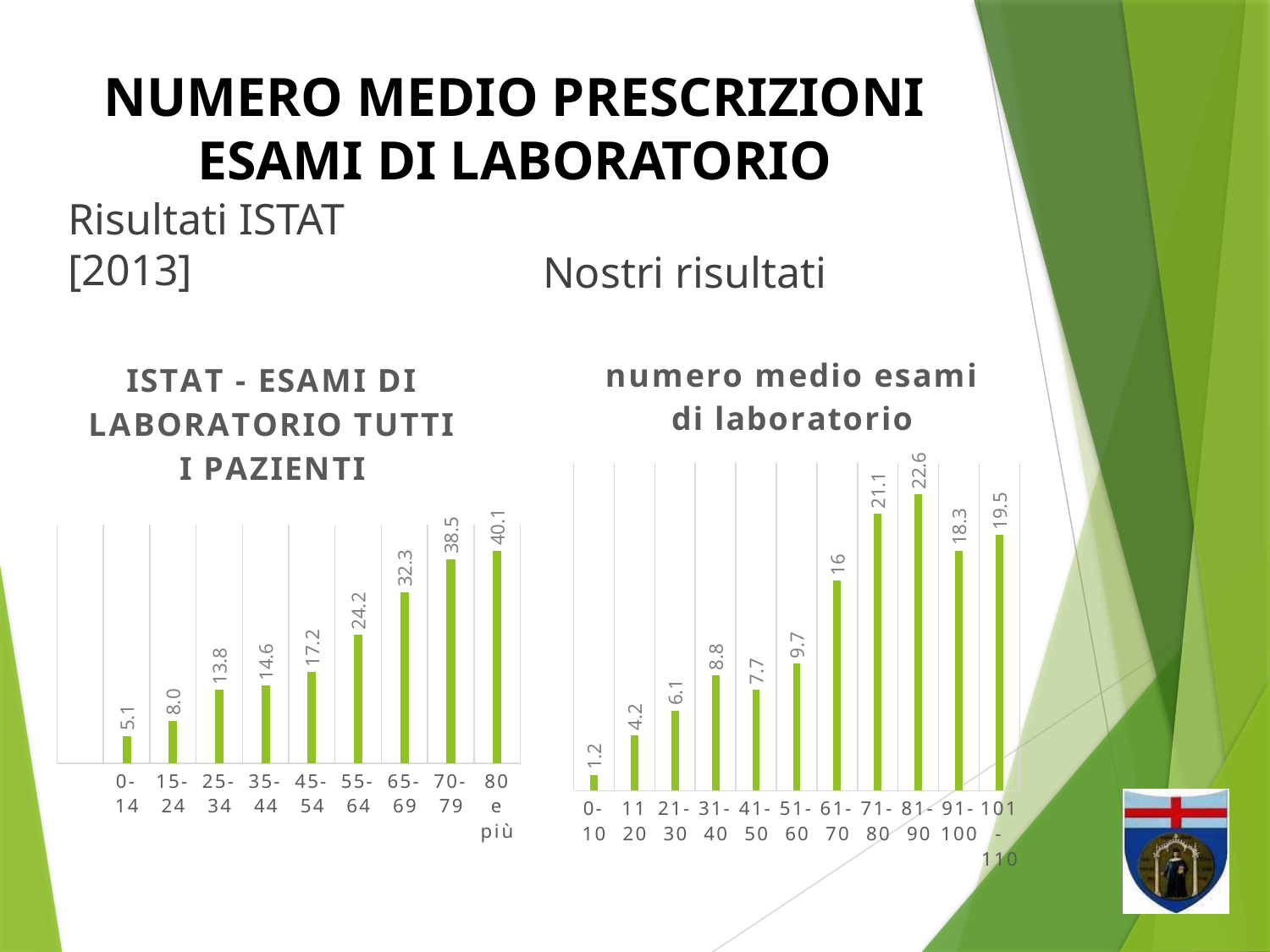
In the chart titled 'ISTAT - ESAMI DI LABORATORIO TUTTI I PAZIENTI', what is the difference between the values for 70-79 and 65-69? 6.2 In the chart titled 'ISTAT - ESAMI DI LABORATORIO TUTTI I PAZIENTI', which age group has the highest value? 80 e più In the chart titled 'numero medio esami di laboratorio', which category has the lowest value? 0-10 What type of chart is the chart titled 'numero medio esami di laboratorio'? bar chart In the chart titled 'ISTAT - ESAMI DI LABORATORIO TUTTI I PAZIENTI', which age group has the lowest value? 0-14 In the chart titled 'numero medio esami di laboratorio', what is the value for the 61-70 category? 16 In the chart titled 'ISTAT - ESAMI DI LABORATORIO TUTTI I PAZIENTI', what is the value for the 55-64 age group? 24.2 In the chart titled 'numero medio esami di laboratorio', which category has the highest value? 81-90 In the chart titled 'ISTAT - ESAMI DI LABORATORIO TUTTI I PAZIENTI', do the values rise or fall as the age groups increase along the x axis? rise In the chart titled 'numero medio esami di laboratorio', which is larger, the value for 31-40 or the value for 41-50? 31-40 In the chart titled 'numero medio esami di laboratorio', how many categories are shown on the x axis? 11 In the chart titled 'ISTAT - ESAMI DI LABORATORIO TUTTI I PAZIENTI', how many age groups are shown on the x axis? 9